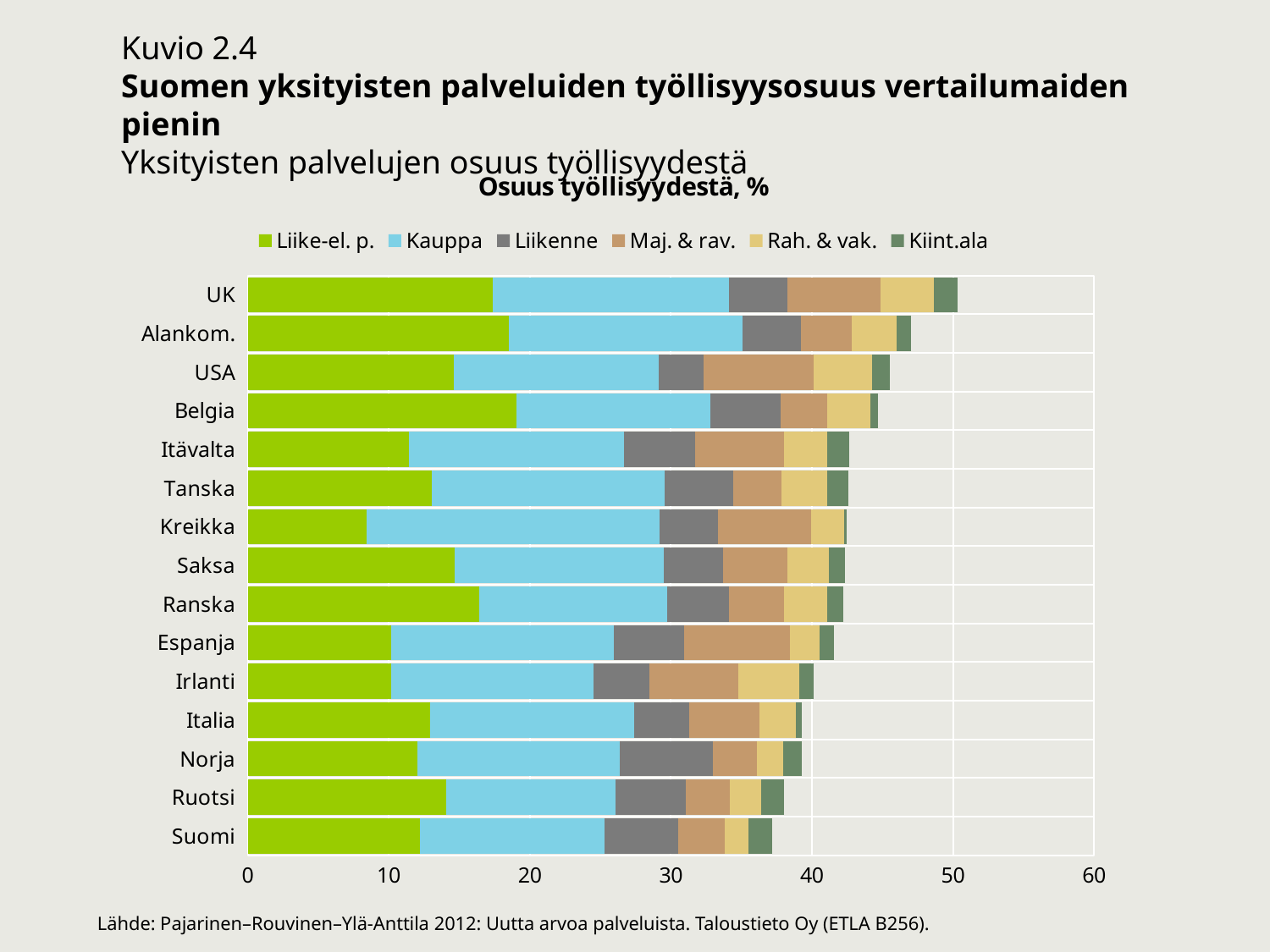
Is the total value for UK greater or less than 40? greater Which has the larger total bar, UK or Suomi? UK Is the total value for Suomi greater or less than 40? less How many countries are listed on the vertical axis of the chart? 15 Which country has the highest total share of private services in employment? UK What kind of chart is shown on the slide? Stacked bar chart Is the total value for Ruotsi greater or less than 40? less How many series does the chart legend list? 6 Which has the larger total bar, Belgia or Norja? Belgia Which country has the lowest total share of private services in employment? Suomi What is the title printed above the chart legend? Osuus työllisyydestä, %